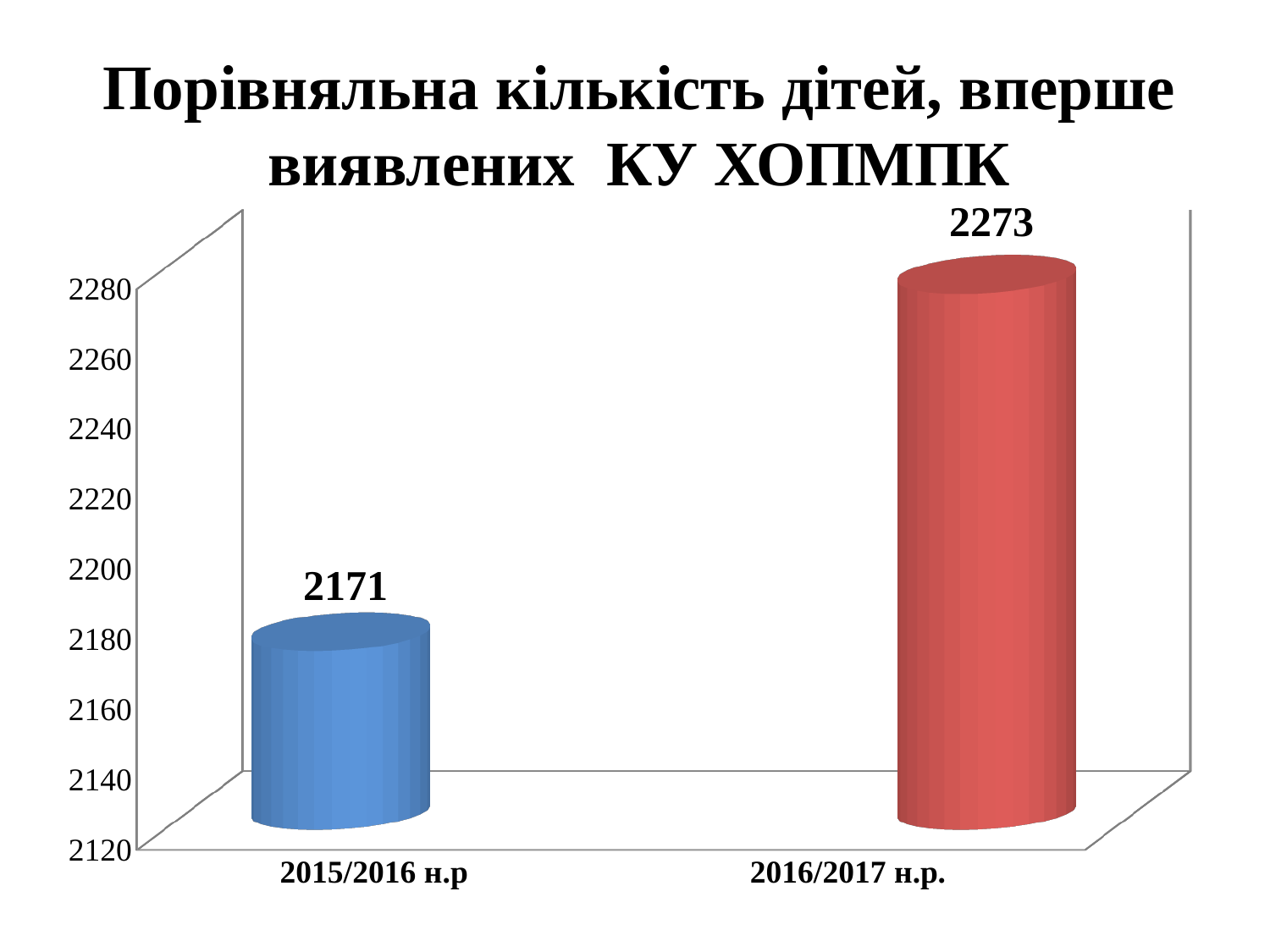
What is the difference between the values for 2016/2017 н.р. and 2015/2016 н.р? 102 Which category has the highest value? 2016/2017 н.р. What kind of chart is shown on the slide? bar chart Do the values rise or fall from 2015/2016 н.р to 2016/2017 н.р.? rise How many categories are shown on the x axis? 2 Which category has the lowest value? 2015/2016 н.р Which is larger, the value for 2015/2016 н.р or the value for 2016/2017 н.р.? 2016/2017 н.р. What is the value for 2016/2017 н.р.? 2273 Is the value for 2016/2017 н.р. greater or less than 2240? greater Is the value for 2015/2016 н.р greater or less than 2200? less What colour is the bar for 2016/2017 н.р.? red What is the value for 2015/2016 н.р? 2171